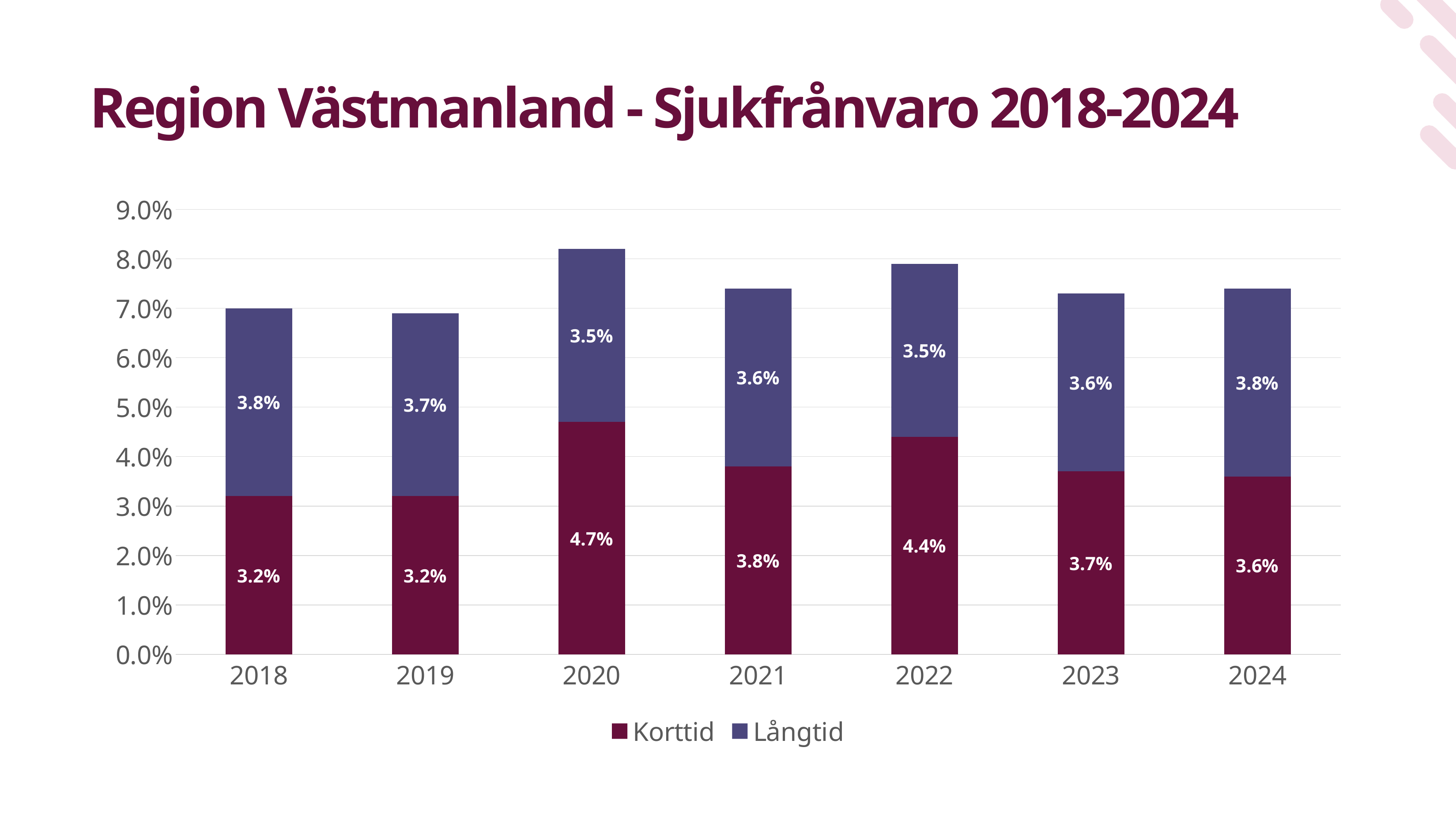
What is the total of the stacked bar for 2018? 7.0% Which year has the lowest Långtid value? 2020 and 2022 (3.5%) How many series does the legend list? 2 What kind of chart is shown on the slide? Stacked bar chart What is the Långtid value for 2024? 3.8% Which is larger, the Korttid value for 2021 or the Korttid value for 2023? 2021 What is the total of the stacked bar for 2020? 8.2% How many years are shown on the x axis? 7 What is the Korttid value for 2022? 4.4% Which year has the highest Korttid value? 2020 What is the Korttid value for 2020? 4.7% What is the difference between the Korttid values for 2020 and 2018? 1.5%